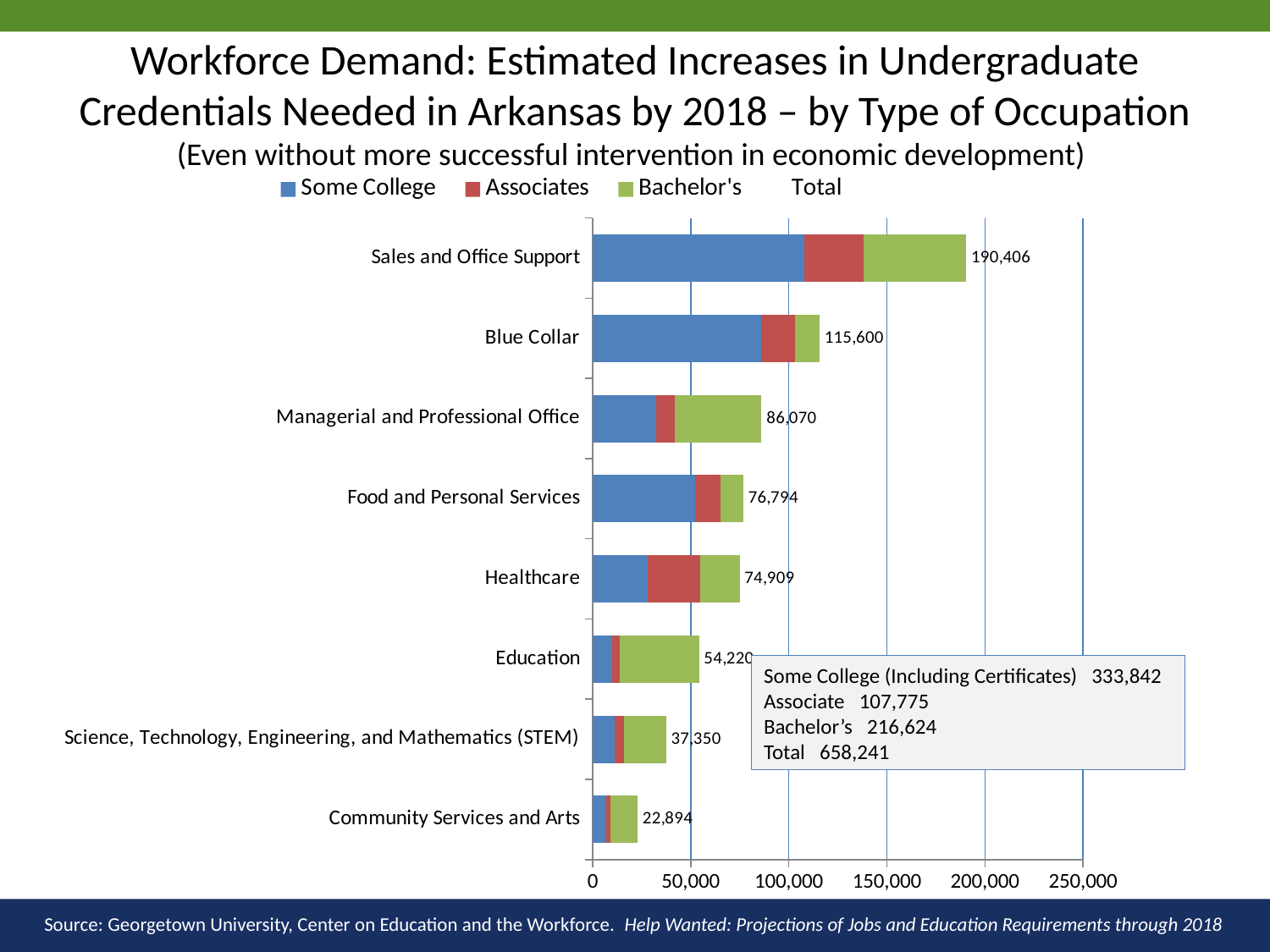
Which occupation type has the lowest total? Community Services and Arts How many occupation types are shown on the chart? 8 What kind of chart is shown on the slide? Stacked bar chart Which colour represents Bachelor's in the chart? Green What is the difference between the totals for Sales and Office Support and Blue Collar? 74,806 What is the total value shown for Sales and Office Support? 190,406 What is the total value shown for Healthcare? 74,909 Which has a larger total, Managerial and Professional Office or Education? Managerial and Professional Office Which occupation type has the highest total? Sales and Office Support What is the total value shown for Science, Technology, Engineering, and Mathematics (STEM)? 37,350 Is the Some College value for Blue Collar greater or less than 100,000? less How many entries does the legend list? 4